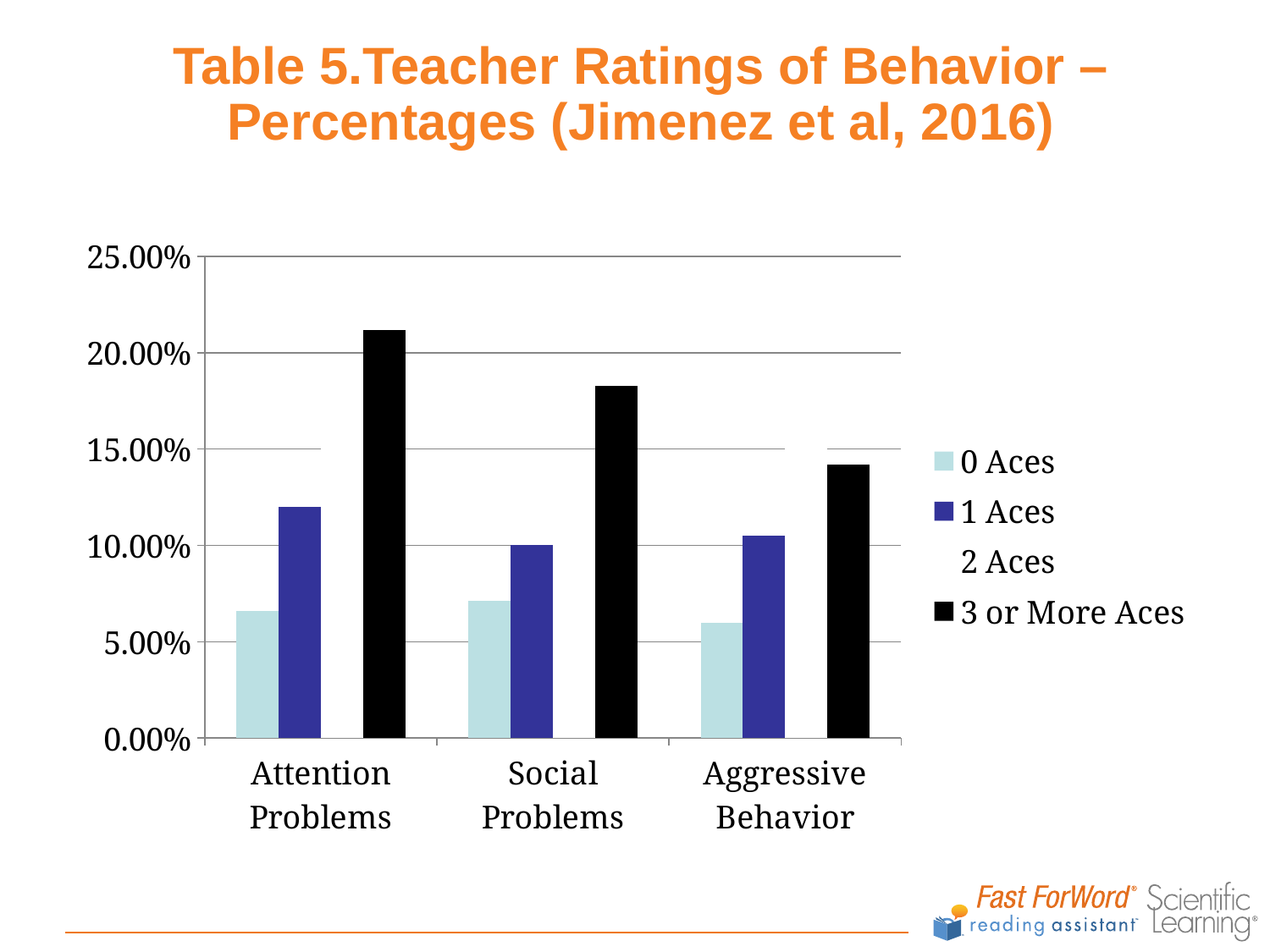
What kind of chart is shown on the slide? bar chart Is the value for 1 Aces in Attention Problems greater or less than 10.00%? greater Is the value for 3 or More Aces in Social Problems greater or less than 20.00%? less Which category has the highest value for 3 or More Aces? Attention Problems How many categories are shown on the x axis? 3 Which is larger for 1 Aces: Attention Problems or Social Problems? Attention Problems Is the value for 3 or More Aces in Attention Problems greater or less than 20.00%? greater Which category has the lowest value for 3 or More Aces? Aggressive Behavior What is the last series listed in the legend? 3 or More Aces How many series does the legend list? 4